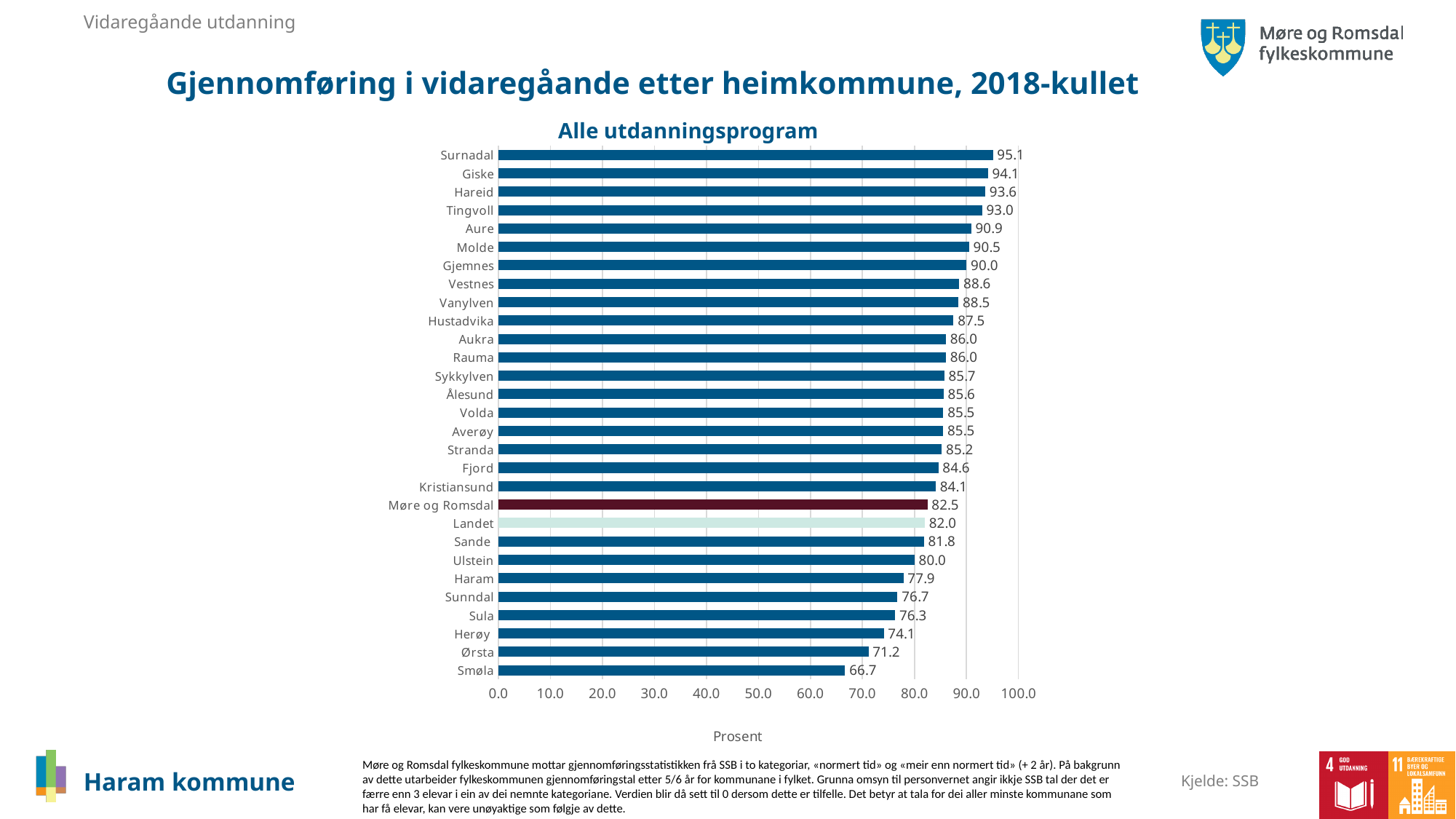
What kind of chart is shown on the slide? bar chart What is the difference between the values for Haram and Landet? 4.1 Which category has the lowest value in the chart? Smøla How many categories (bars) are shown in the chart? 29 Which has a larger value, Molde or Ålesund? Molde What is the value for Haram in the chart? 77.9 Is the value for Ørsta greater or less than 80.0? less What is the value for Landet in the chart? 82.0 What is the value for Møre og Romsdal in the chart? 82.5 Which category has the highest value in the chart? Surnadal What is the difference between the values for Surnadal and Smøla? 28.4 What is the title of the chart? Alle utdanningsprogram